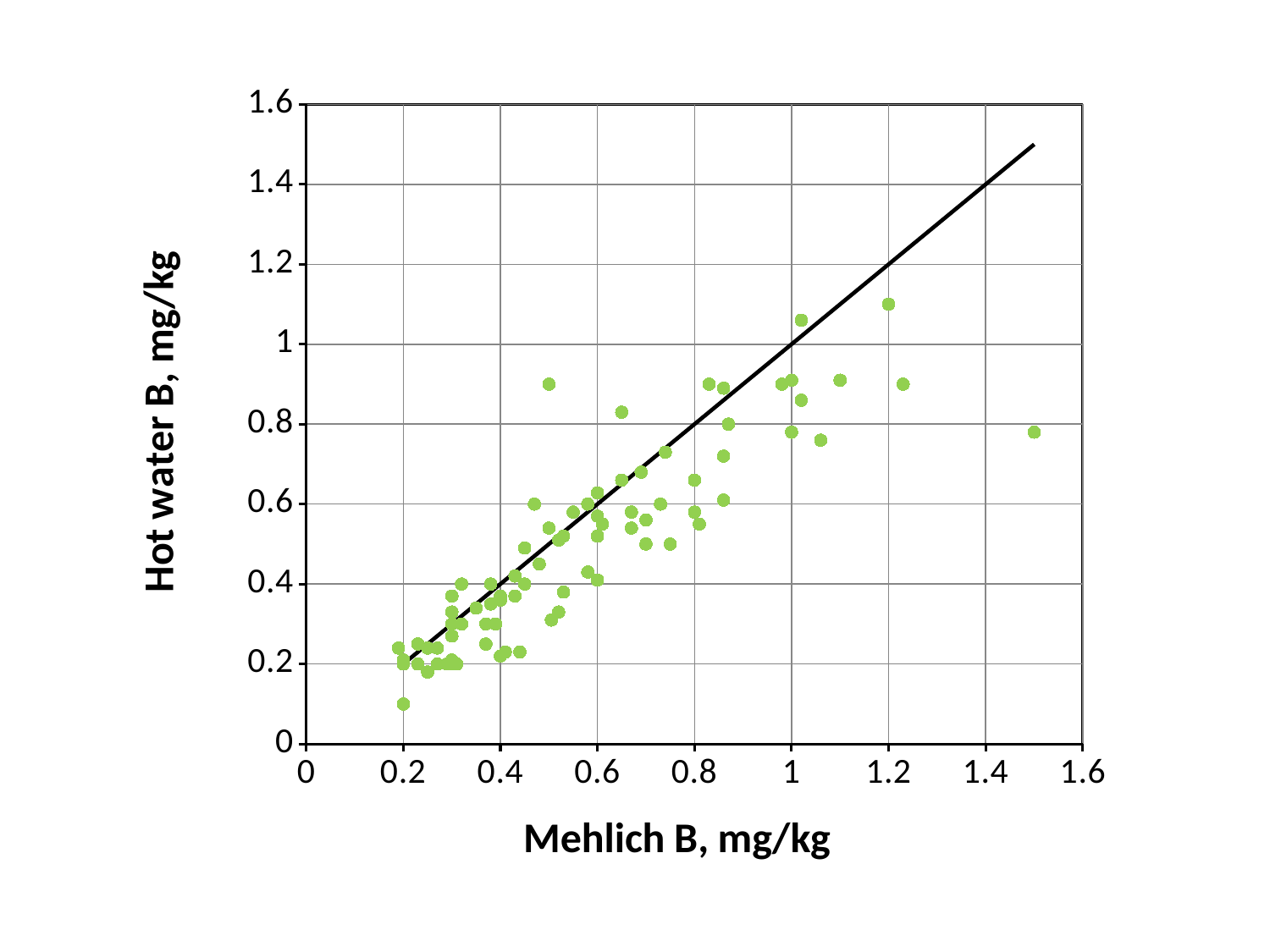
Is the Mehlich B value of the rightmost point greater or less than 1.4? greater What kind of chart is shown on the slide? scatter chart Is the highest Hot water B value plotted greater or less than 1.0? greater Is the Hot water B value for the point with the highest Mehlich B (about 1.5 mg/kg) greater or less than 1.0? less Do the Hot water B values generally rise or fall as Mehlich B increases along the x axis? rise What is the label of the x axis? Mehlich B, mg/kg Does the fitted line slope upward or downward from left to right? upward What is the label of the y axis? Hot water B, mg/kg